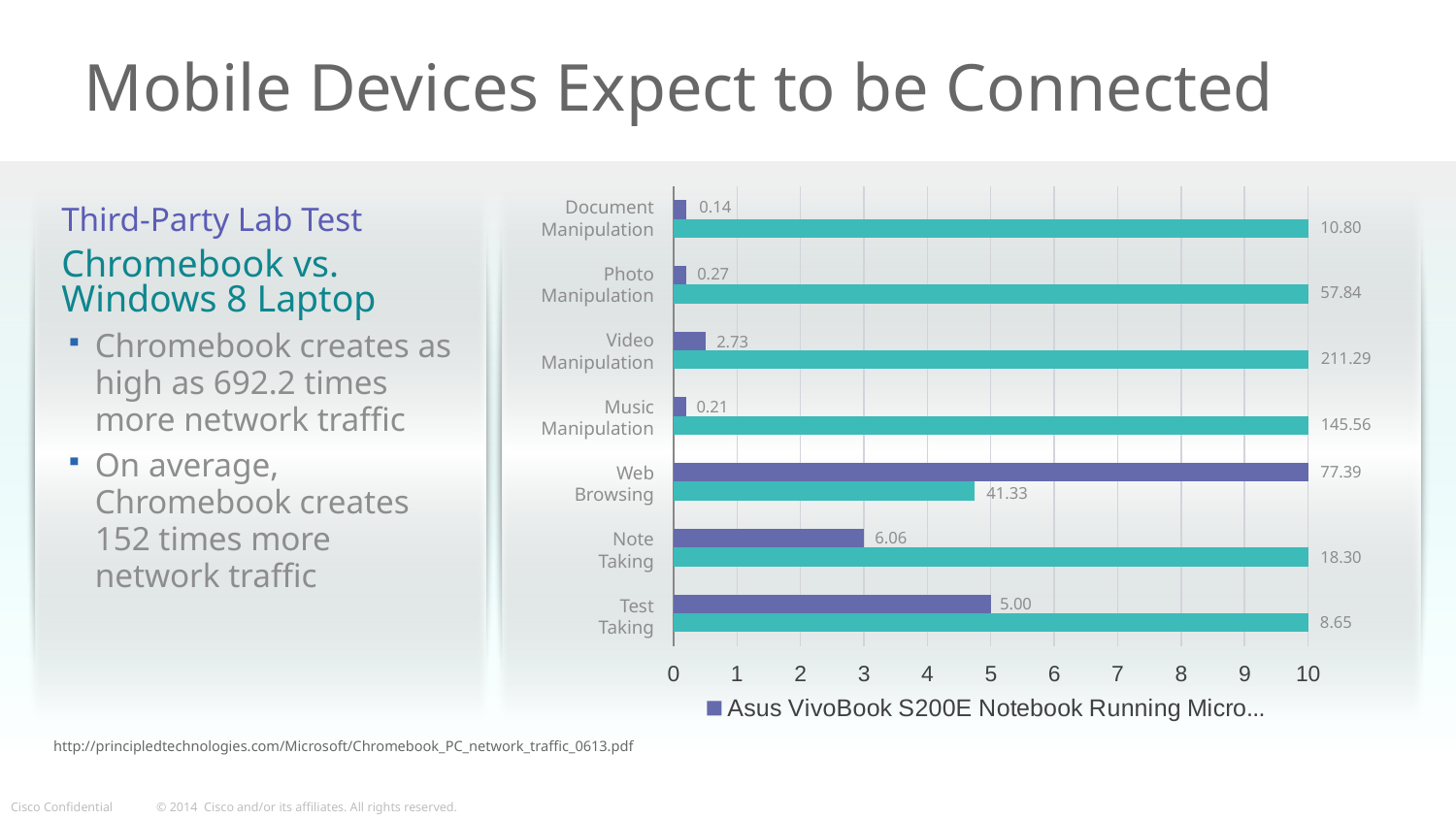
Which category has the lowest value for the Asus VivoBook S200E Notebook series? Document Manipulation Which category has the highest value among the teal bars? Video Manipulation For Note Taking, what is the difference between the teal bar value and the Asus VivoBook S200E Notebook value? 12.24 Which category has the highest value for the Asus VivoBook S200E Notebook series? Web Browsing What is the value of the teal bar for Photo Manipulation? 57.84 What kind of chart is shown on the slide? Bar chart What is the value for the Asus VivoBook S200E Notebook series for Video Manipulation? 2.73 What is the value of the teal bar for Music Manipulation? 145.56 For Test Taking, what is the difference between the teal bar value and the Asus VivoBook S200E Notebook value? 3.65 What is the value for the Asus VivoBook S200E Notebook series for Web Browsing? 77.39 How many categories are shown on the chart? 7 For Web Browsing, which is larger: the Asus VivoBook S200E Notebook value or the teal bar value? Asus VivoBook S200E Notebook